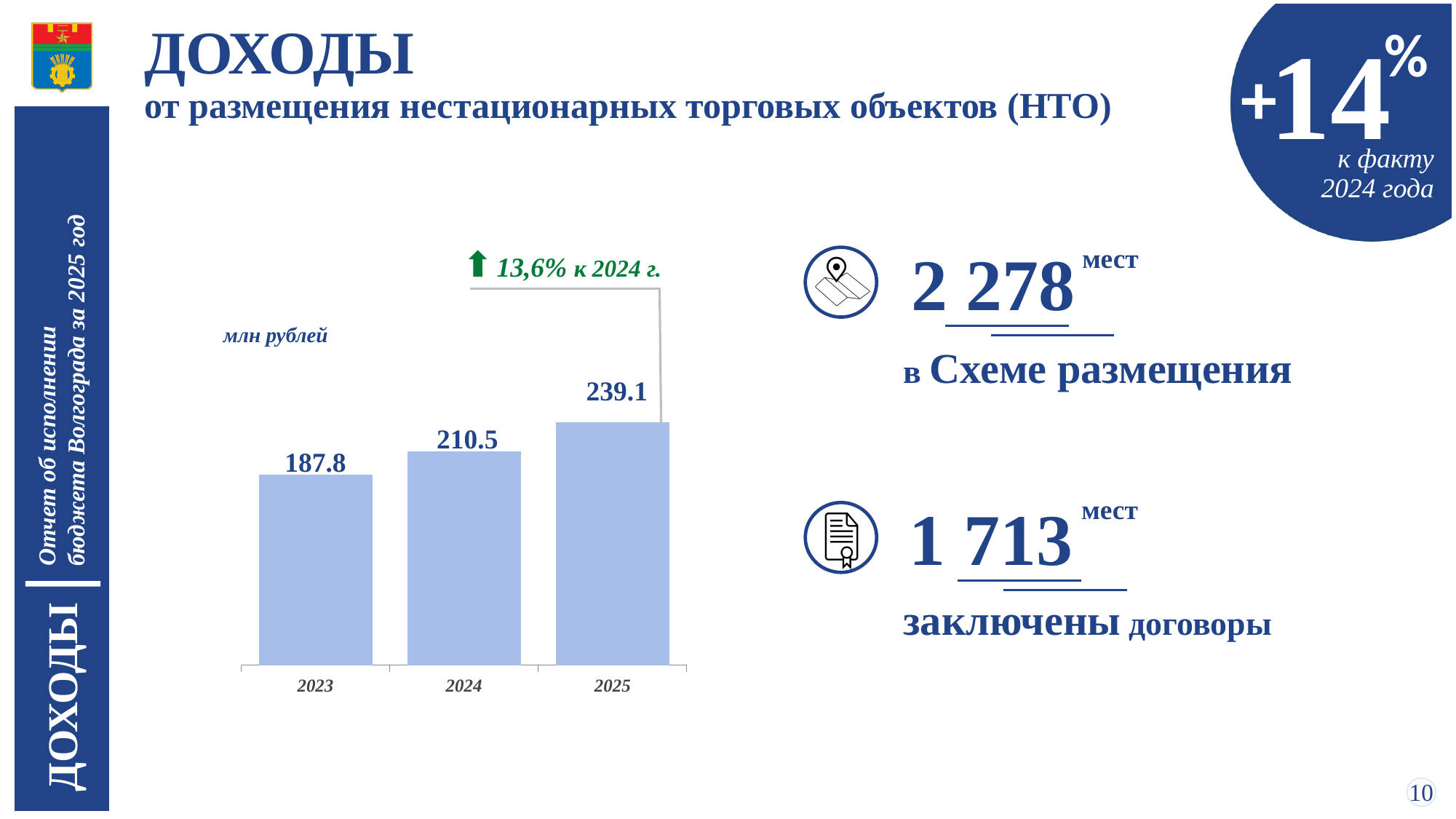
What is the value for 2023? 187.8 What is the difference between the values for 2025 and 2024? 28.6 Which is larger, the value for 2024 or the value for 2023? 2024 What is the difference between the values for 2024 and 2023? 22.7 What is the value for 2024? 210.5 Which year has the highest value? 2025 How many years are shown on the chart? 3 What kind of chart is shown on the slide? bar chart What unit is stated for the values on the chart? млн рублей What is the value for 2025? 239.1 Do the values rise or fall from 2023 to 2025? rise Which year has the lowest value? 2023